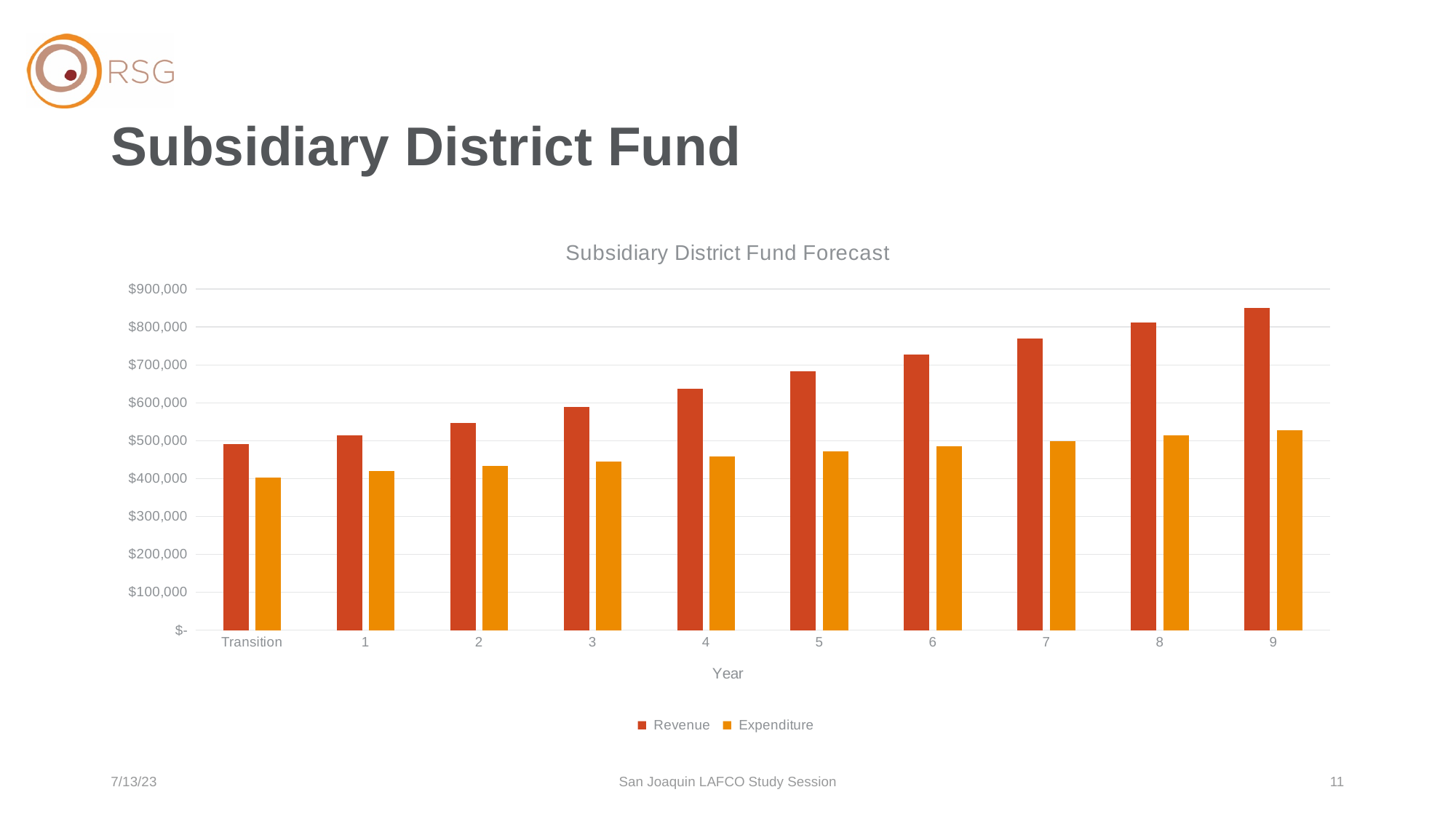
Which year has the highest Revenue? 9 Is the Revenue value for Year 5 greater or less than $600,000? greater Which category has the lowest Expenditure? Transition What is the title of the chart? Subsidiary District Fund Forecast Is the Expenditure value for Transition greater or less than $500,000? less How many series does the legend list? 2 What kind of chart is shown on the slide? bar chart Do Revenue values rise or fall from Transition to Year 9? rise Is the Revenue value for Year 9 greater or less than $800,000? greater What is the label on the x axis of the chart? Year In Year 9, which is larger, Revenue or Expenditure? Revenue How many categories are shown along the x axis? 10